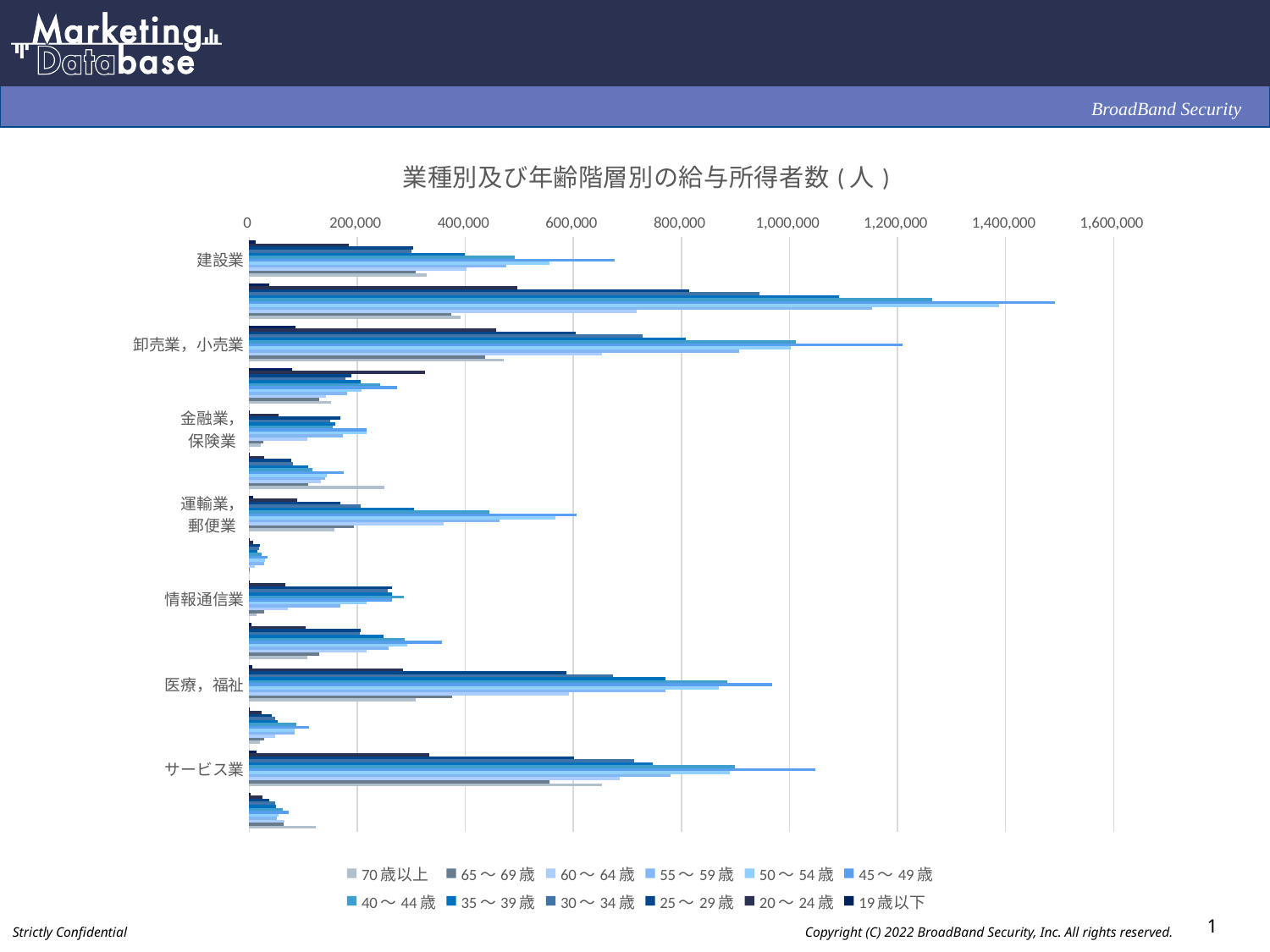
Is the longest bar for 建設業 greater or less than 600,000? greater Which has the longer longest bar, 卸売業，小売業 or 情報通信業? 卸売業，小売業 How many series does the legend list? 12 Is the longest bar for 金融業，保険業 greater or less than 400,000? less Is the longest bar for 医療，福祉 greater or less than 800,000? greater What is the highest value shown on the horizontal axis? 1,600,000 What kind of chart is shown on the slide? bar chart What is the title of the chart? 業種別及び年齢階層別の給与所得者数（人）